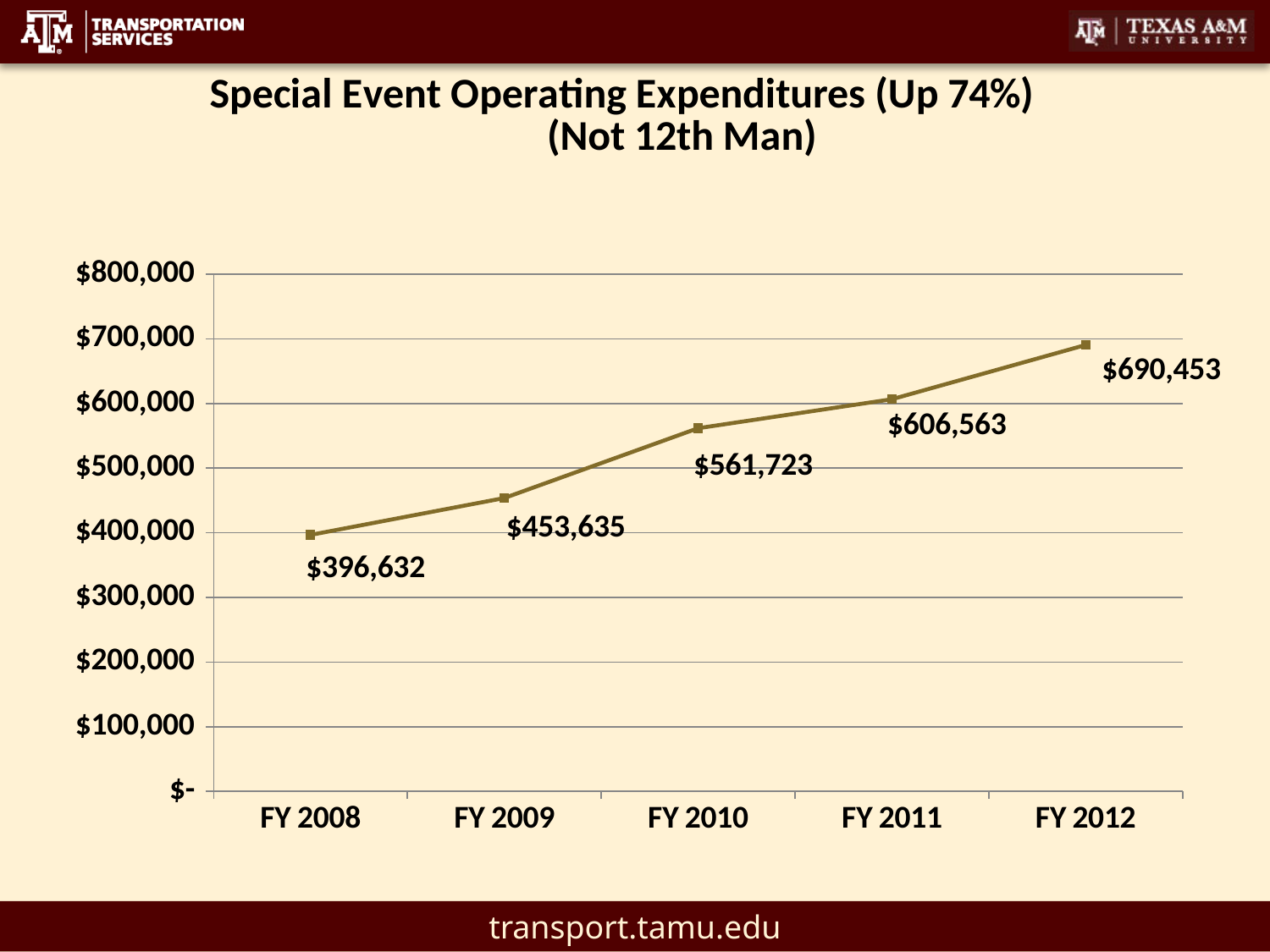
How many fiscal years are plotted on the chart? 5 Which fiscal year had the highest special event operating expenditure? FY 2012 Is the value for FY 2011 greater or less than $600,000? greater What was the special event operating expenditure in FY 2010? $561,723 What is the difference between the FY 2011 and FY 2010 expenditures? $44,840 What kind of chart is shown on the slide? line chart What was the special event operating expenditure in FY 2012? $690,453 Do the expenditures rise or fall from FY 2008 to FY 2012? rise What was the special event operating expenditure in FY 2008? $396,632 What is the difference between the FY 2012 and FY 2008 expenditures? $293,821 Which fiscal year had the lowest special event operating expenditure? FY 2008 Which is larger, the expenditure in FY 2009 or in FY 2011? FY 2011